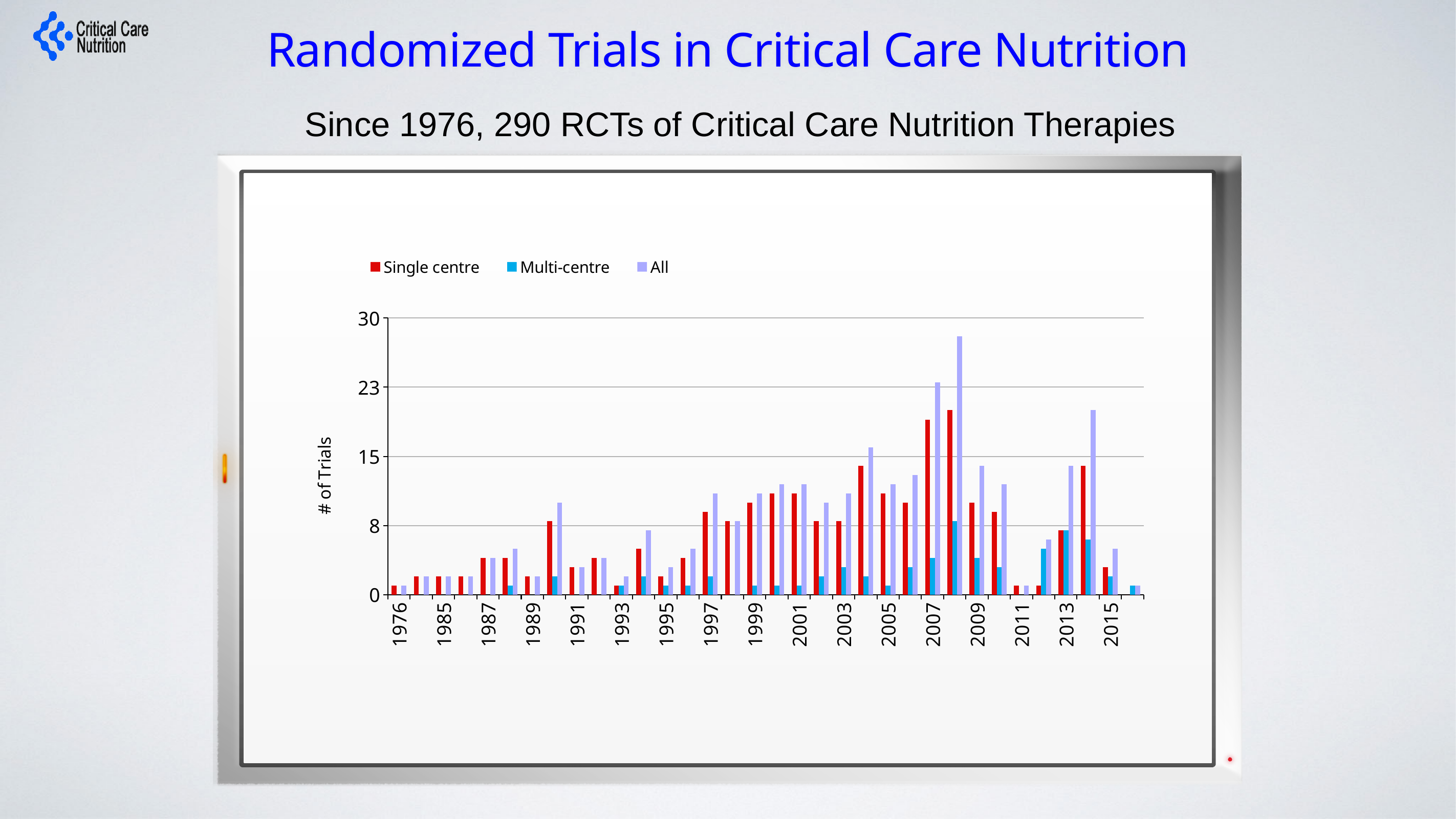
What is the label on the vertical axis of the chart? # of Trials Which is larger, the Single centre value for 2007 or the Single centre value for 2011? 2007 Which series has the shortest bar in 2007? Multi-centre What are the three series named in the legend? Single centre, Multi-centre, All Which series has the tallest bar in 2007? All Is the Single centre value for 2007 greater or less than 15? greater Does the All series generally rise or fall from 1976 to 2007? rise What kind of chart is shown on the slide? bar chart Is the All value for 1997 greater or less than 8? greater How many series does the chart legend list? 3 Is the Single centre value for 2011 greater or less than 8? less